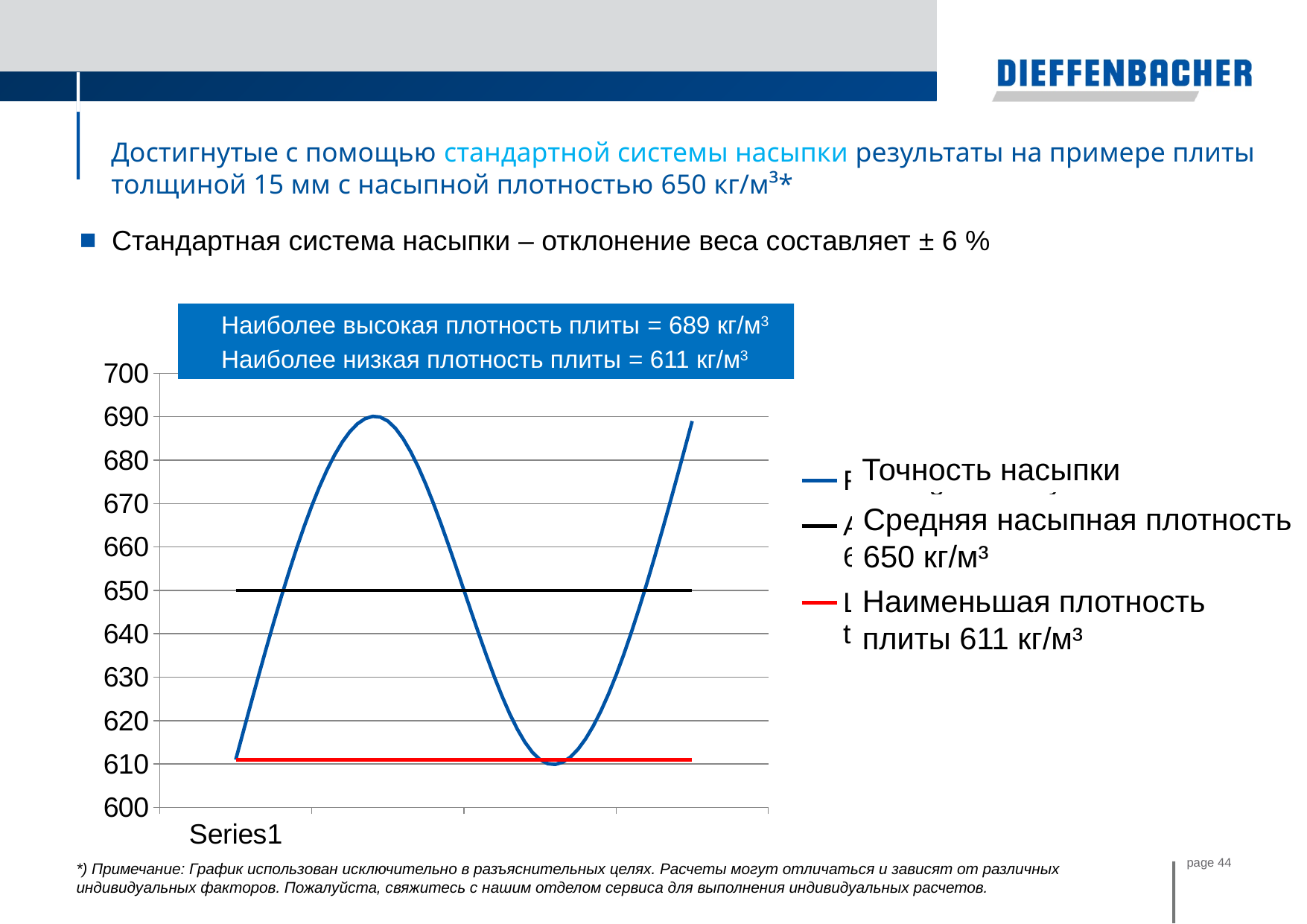
What is the lowest board density reached by the blue curve, according to the text box above the chart? 611 кг/м³ How many series does the chart legend list? 3 What is the highest board density reached by the blue curve, according to the text box above the chart? 689 кг/м³ What kind of chart is shown on the slide? line chart Is the lowest point of the blue curve greater or less than 620? less What is the difference between the highest board density (689 кг/м³) and the lowest board density (611 кг/м³)? 78 кг/м³ What value does the black horizontal line (Средняя насыпная плотность) represent? 650 кг/м³ Which line is higher on the chart, the black average density line or the red lowest density line? the black average density line Is the peak of the blue curve greater or less than 680? greater What value does the red horizontal line (Наименьшая плотность плиты) represent? 611 кг/м³ Does the blue curve initially rise or fall from its starting point on the left? rise What colour is the line representing the average bulk density of 650 кг/м³? black